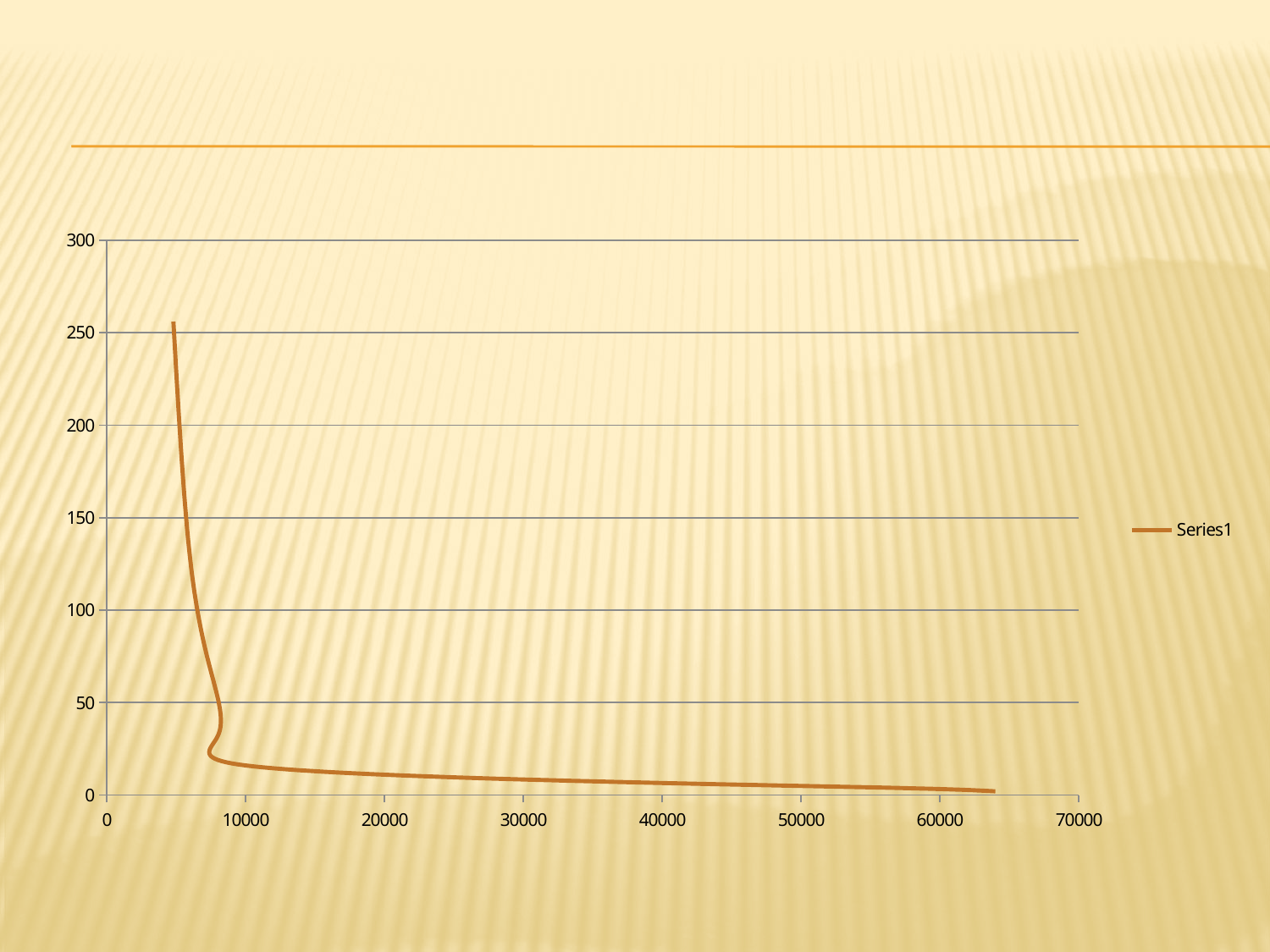
Is the highest value reached by Series1 greater or less than 200? greater Is the highest value reached by Series1 greater or less than 300? less Do the values of Series1 rise or fall as the x-axis value increases? fall What is the name of the series shown in the legend? Series1 What kind of chart is shown on the slide? line chart Is the value of Series1 at x = 10000 greater or less than 100? less What is the maximum value shown on the vertical axis? 300 How many series does the legend list? 1